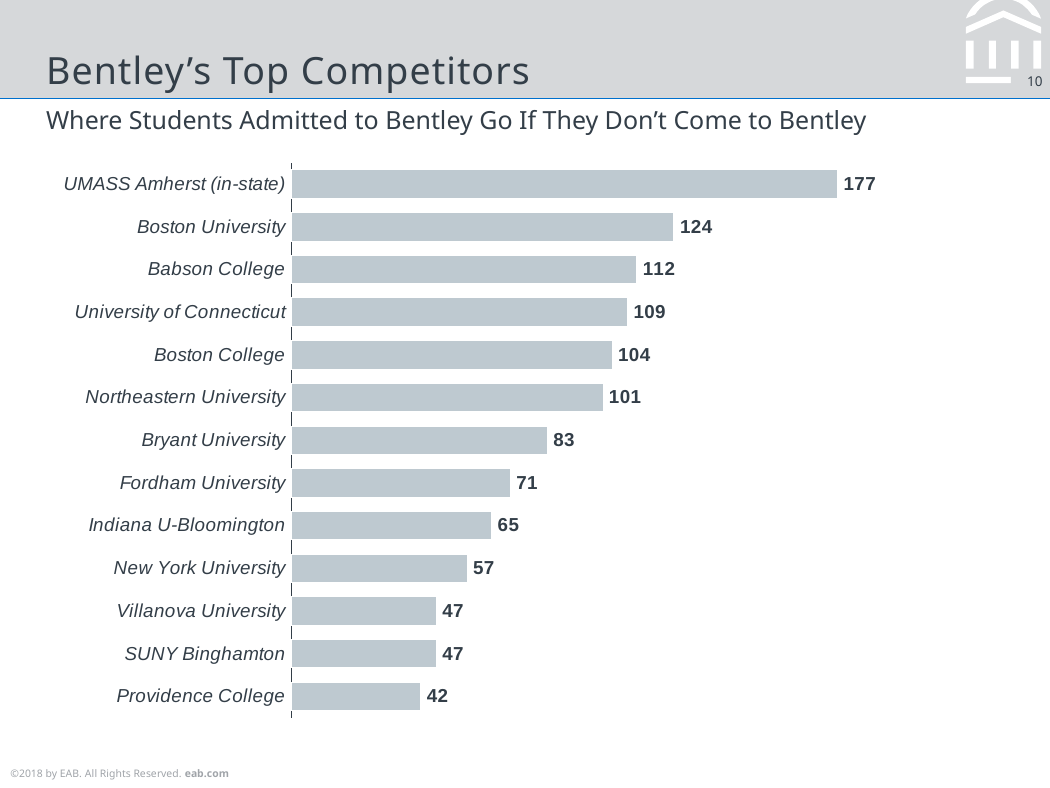
What is the value for Boston University? 124 What is the difference between the values for Bryant University and Fordham University? 12 Which category has the highest value? UMASS Amherst (in-state) What is the difference between the values for UMASS Amherst (in-state) and Boston University? 53 What is the value for Northeastern University? 101 What kind of chart is shown on the slide? Bar chart Which two categories share the same value of 47? Villanova University and SUNY Binghamton Which is larger, the value for Babson College or the value for Boston College? Babson College How many categories are shown in the chart? 13 What is the value for New York University? 57 Which category has the lowest value? Providence College What is the subtitle shown above the chart? Where Students Admitted to Bentley Go If They Don't Come to Bentley